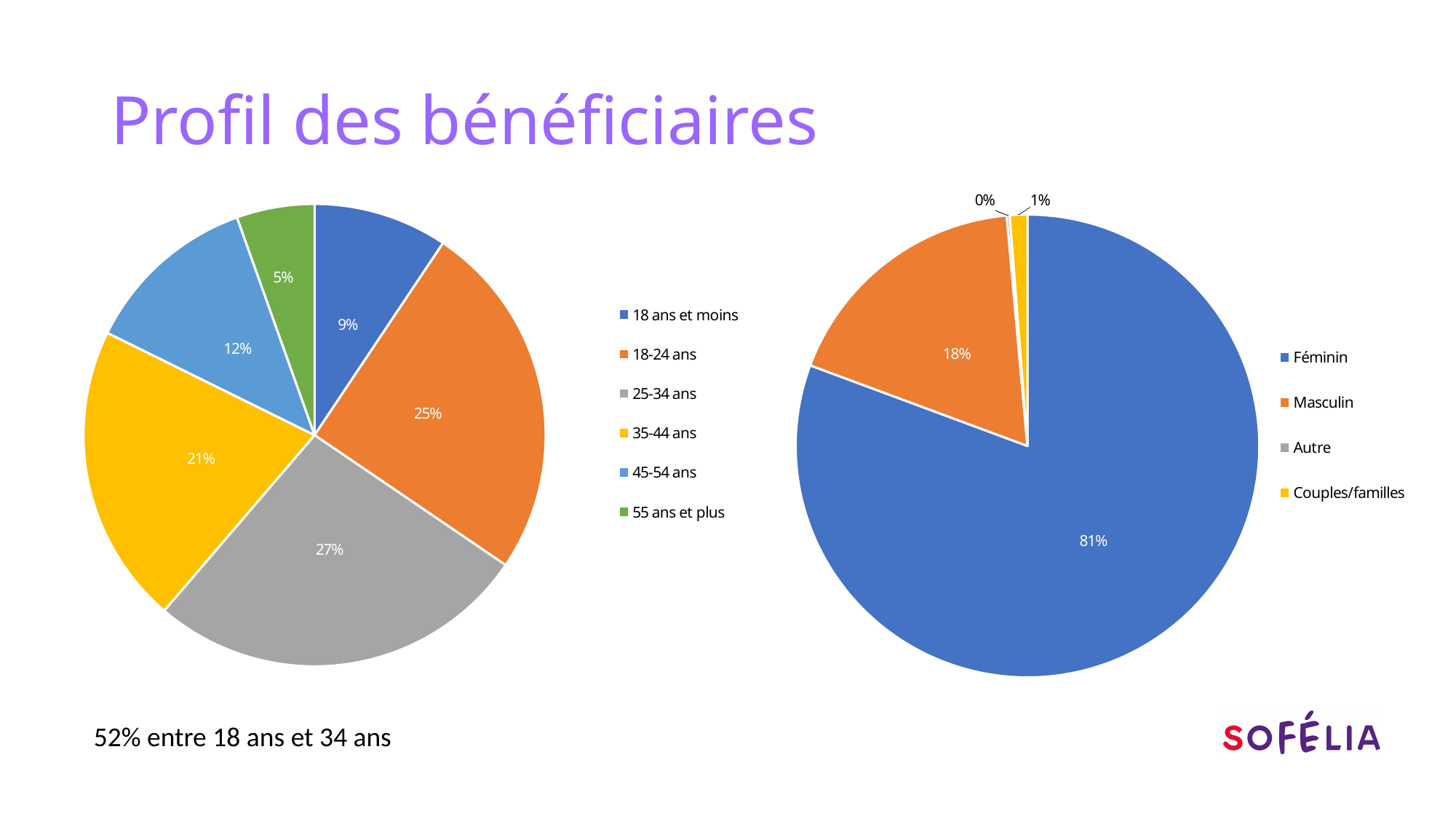
What kind of chart is used on the right side of the slide? Pie chart In the left pie chart (age groups), which age group has the smallest share? 55 ans et plus In the left pie chart (age groups), which age group has the largest share? 25-34 ans In the right pie chart (gender), what colour is the Féminin slice? Blue In the right pie chart (gender), what share is shown for Masculin? 18% In the left pie chart (age groups), what share is shown for 18 ans et moins? 9% In the left pie chart (age groups), what share is shown for 25-34 ans? 27% In the right pie chart (gender), which is larger, the share for Féminin or the share for Masculin? Féminin In the left pie chart (age groups), how many categories does the legend list? 6 In the right pie chart (gender), what share is shown for Couples/familles? 1% In the right pie chart (gender), which category has the largest share? Féminin In the left pie chart (age groups), what is the difference between the shares for 35-44 ans and 45-54 ans? 9%